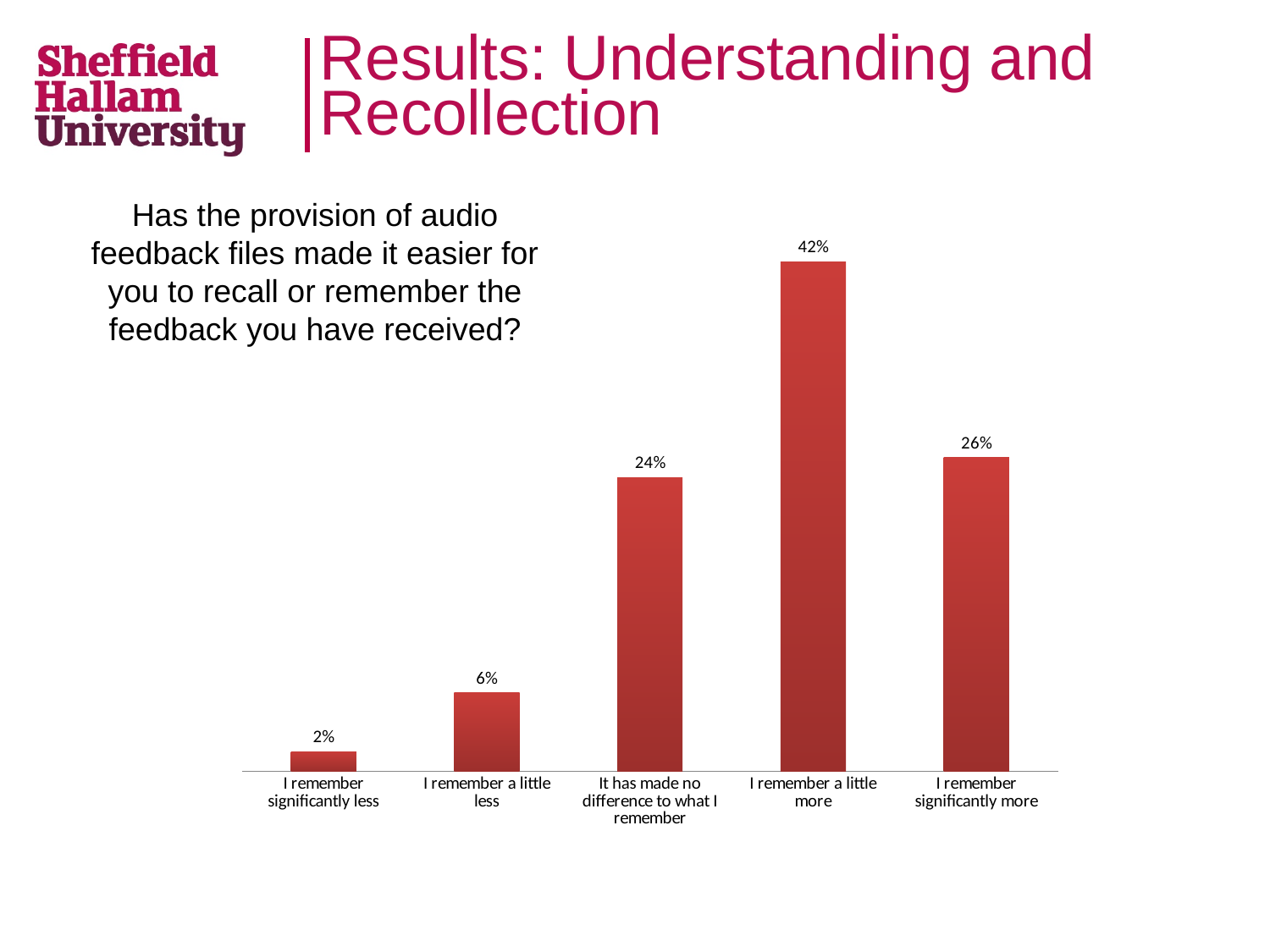
What question does the chart present responses to? Has the provision of audio feedback files made it easier for you to recall or remember the feedback you have received? Which response category has the highest value? I remember a little more What is the combined percentage of 'I remember a little more' and 'I remember significantly more'? 68% What is the value for 'I remember significantly more'? 26% What is the value for 'I remember significantly less'? 2% What is the difference between 'I remember a little more' and 'I remember significantly more'? 16% Which response category has the lowest value? I remember significantly less What percentage said 'It has made no difference to what I remember'? 24% Which is larger: 'I remember a little less' or 'It has made no difference to what I remember'? It has made no difference to what I remember What percentage of respondents said 'I remember a little more'? 42% What type of chart is shown on the slide? Bar chart How many response categories are shown in the chart? 5